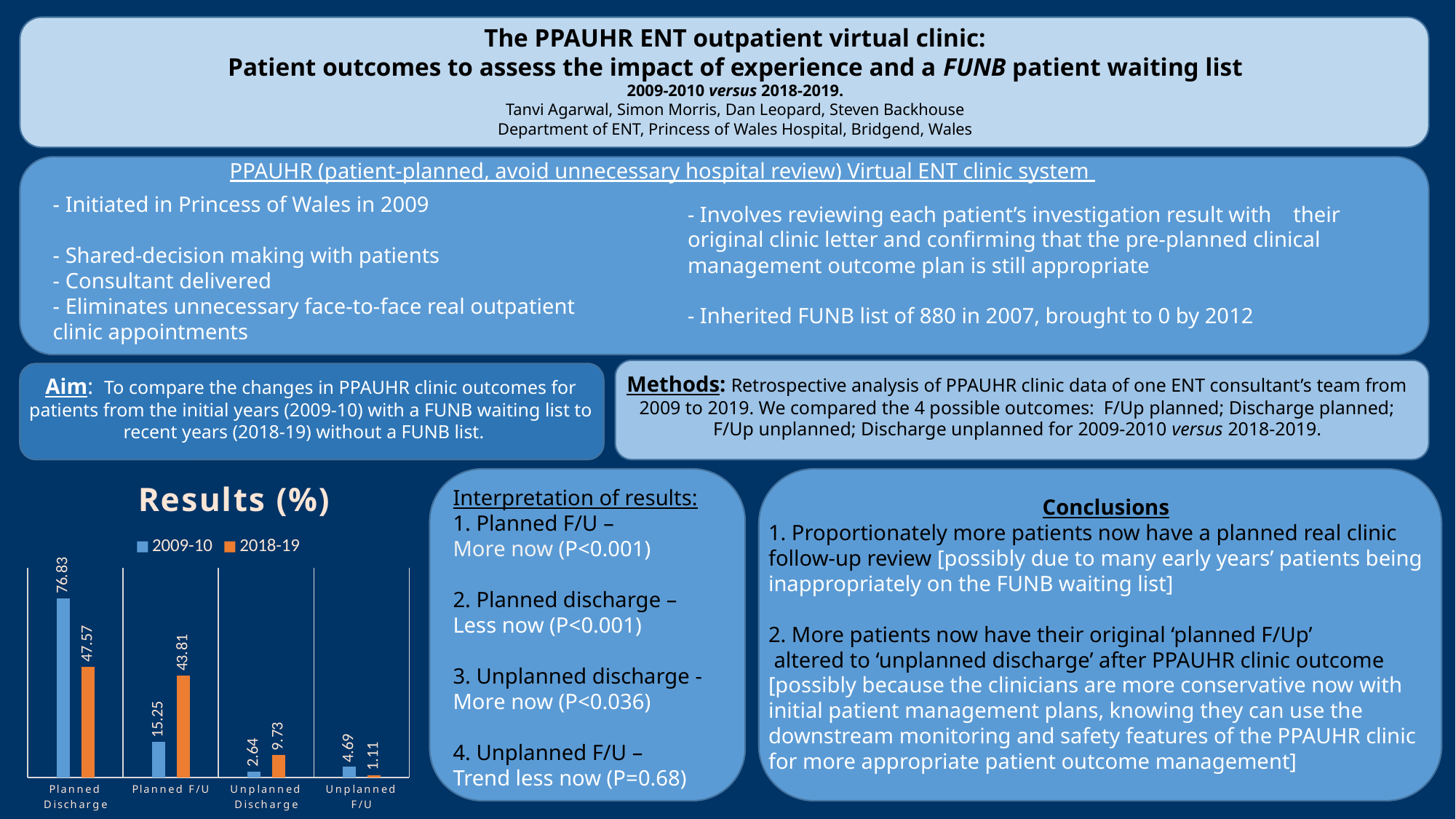
What type of chart is the Results (%) chart? Bar chart What is the 2009-10 value for Unplanned F/U in the Results (%) chart? 4.69 How many series does the legend of the Results (%) chart list? 2 How many categories are shown on the x axis of the Results (%) chart? 4 What is the 2018-19 value for Planned F/U in the Results (%) chart? 43.81 What is the difference between the 2009-10 and 2018-19 values for Planned Discharge in the Results (%) chart? 29.26 In the Results (%) chart, which is larger for Unplanned F/U: the 2009-10 value or the 2018-19 value? 2009-10 What is the difference between the 2018-19 and 2009-10 values for Planned F/U in the Results (%) chart? 28.56 Which category has the highest 2009-10 value in the Results (%) chart? Planned Discharge What is the 2018-19 value for Unplanned Discharge in the Results (%) chart? 9.73 Which category has the lowest 2018-19 value in the Results (%) chart? Unplanned F/U What is the 2009-10 value for Planned Discharge in the Results (%) chart? 76.83